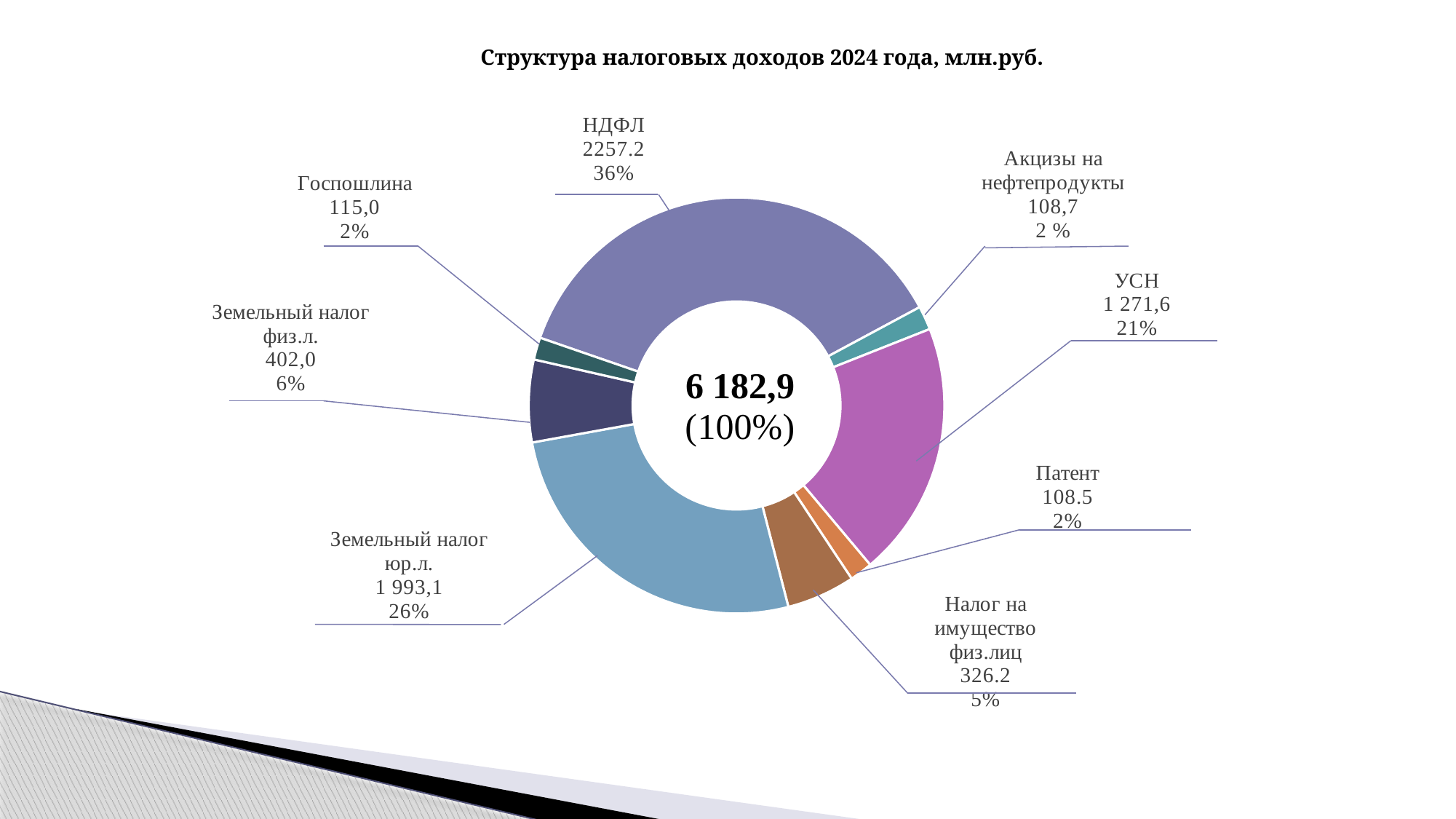
What is the value for Налог на имущество физ.лиц? 326.2 What share of the total does Земельный налог юр.л. represent? 26% What is the difference between the values for НДФЛ and Земельный налог юр.л.? 264,1 Which is larger, Земельный налог физ.л. or Госпошлина? Земельный налог физ.л. What is the value for НДФЛ? 2257.2 Which category has the largest slice? НДФЛ What share of the total does УСН represent? 21% How many categories are shown in the chart? 8 What total value is shown in the centre of the chart? 6 182,9 What kind of chart is shown on the slide? Doughnut (pie) chart What is the value for Земельный налог юр.л.? 1 993,1 What is the value for УСН? 1 271,6